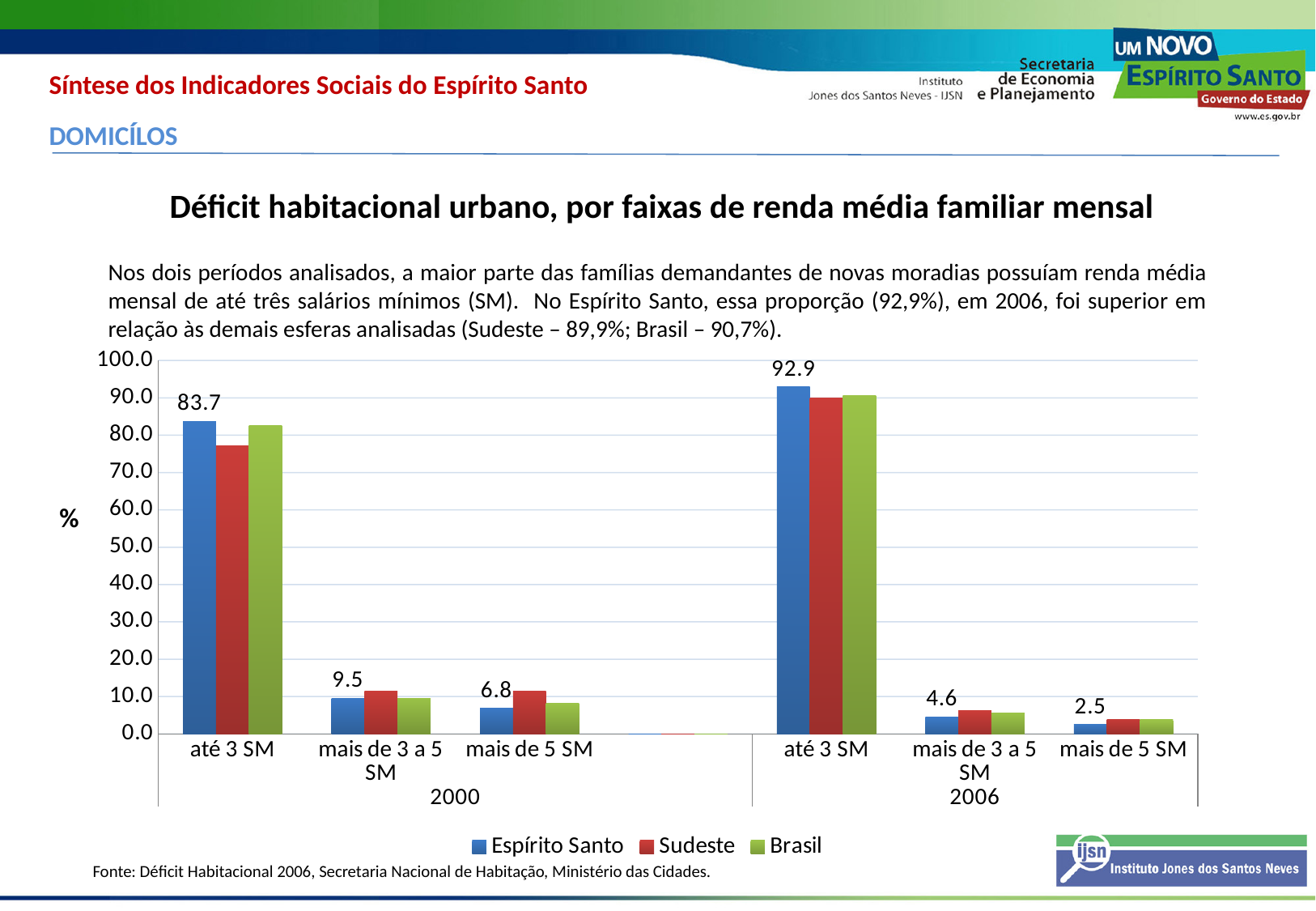
For Espírito Santo in the 'até 3 SM' category, which year has the larger value, 2000 or 2006? 2006 What is the value for Espírito Santo in the 'até 3 SM' category for 2000? 83.7 What is the difference between the Espírito Santo values for 'mais de 3 a 5 SM' and 'mais de 5 SM' in 2000? 2.7 By how much did the Espírito Santo value for 'até 3 SM' increase from 2000 to 2006? 9.2 Is the value for Sudeste in the 'até 3 SM' category for 2000 greater or less than 80? less Is the value for Sudeste in the 'até 3 SM' category for 2006 greater or less than 80? greater What is the value for Espírito Santo in the 'mais de 3 a 5 SM' category for 2000? 9.5 How many series does the legend list? 3 What kind of chart is shown on the slide? Bar chart Which series has the highest value in the 'até 3 SM' category for 2006? Espírito Santo What is the value for Espírito Santo in the 'até 3 SM' category for 2006? 92.9 What is the value for Espírito Santo in the 'mais de 5 SM' category for 2006? 2.5